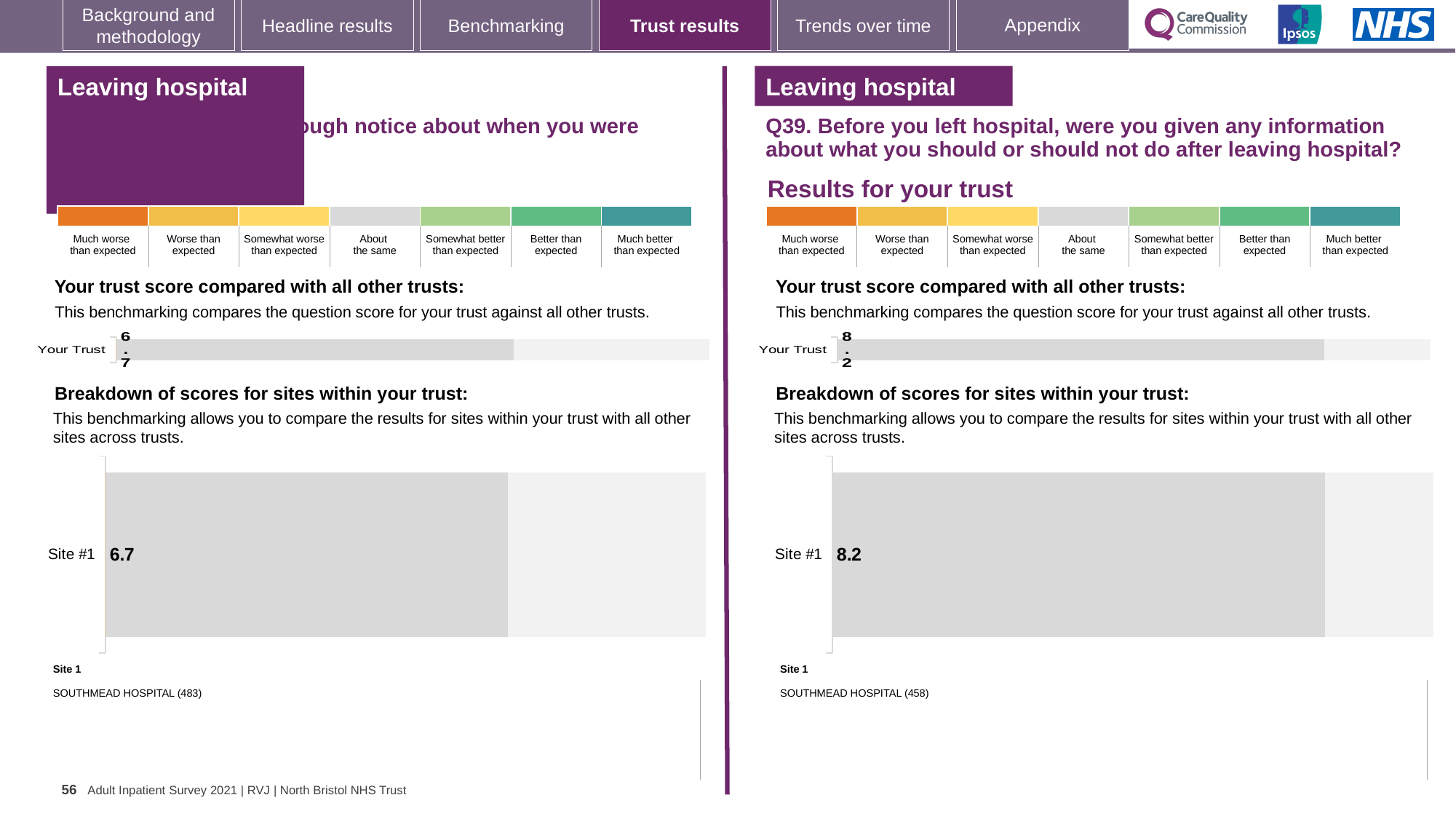
On the right-hand panel (Q39), what is the score shown for Site #1 in the breakdown of scores for sites? 8.2 What is the difference between the Your Trust score on the right-hand panel (Q39) and the Your Trust score on the left-hand panel? 1.5 Which hospital is listed as Site 1 on the left-hand panel? SOUTHMEAD HOSPITAL (483) How many sites are shown in the breakdown of scores for sites on the right-hand panel (Q39)? 1 What type of chart is used to show the Site #1 score on the left-hand panel? Bar chart On the left-hand panel, what is the score shown for Site #1 in the breakdown of scores for sites? 6.7 Which hospital is listed as Site 1 on the right-hand panel (Q39)? SOUTHMEAD HOSPITAL (458) On the left-hand panel, what is the score shown for Your Trust? 6.7 On the right-hand panel (Q39), what is the score shown for Your Trust? 8.2 Which is larger: the Site #1 score on the left-hand panel or the Site #1 score on the right-hand panel (Q39)? Right-hand panel (Q39) What is the difference between the Site #1 score on the right-hand panel (Q39) and the Site #1 score on the left-hand panel? 1.5